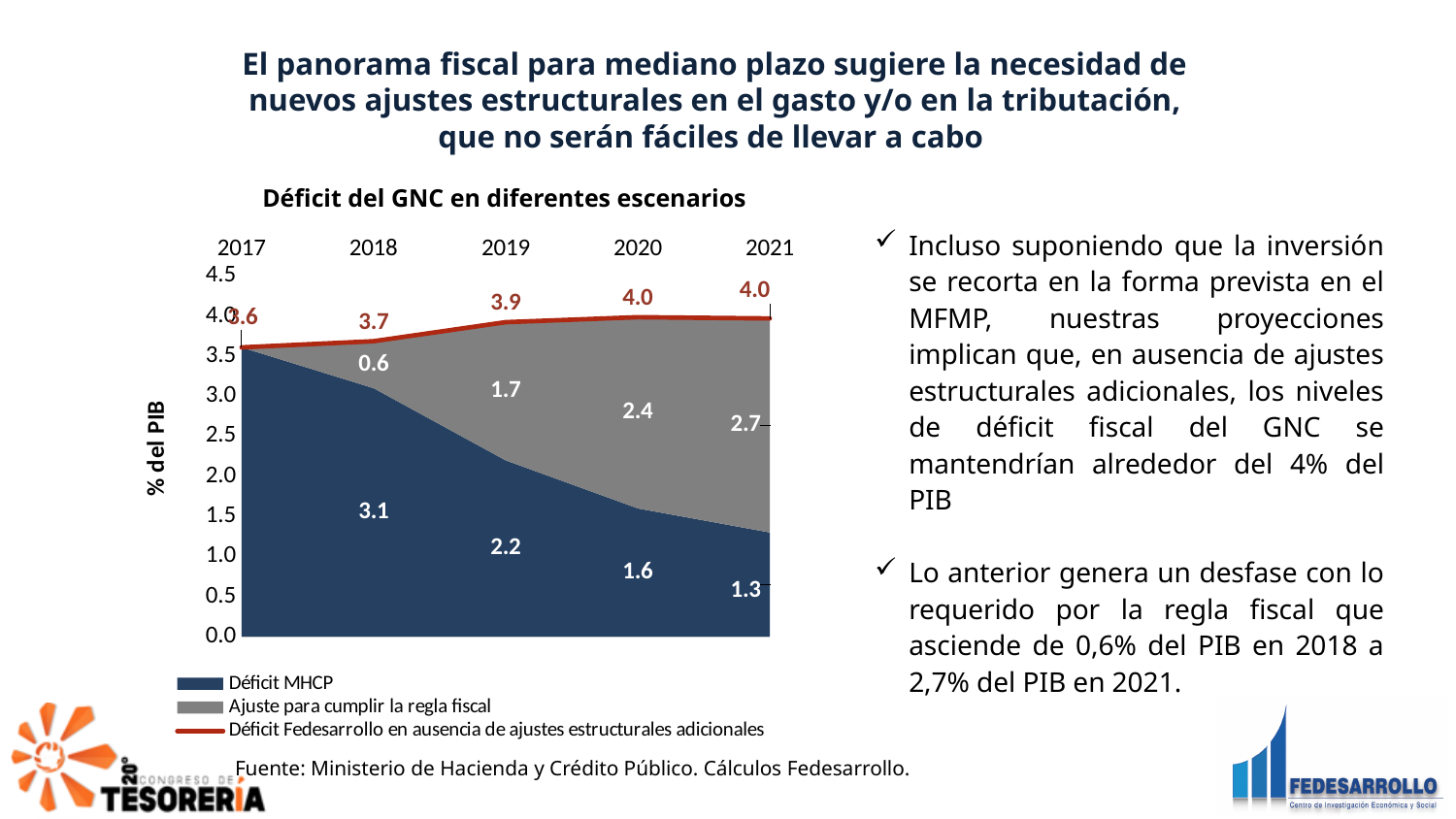
Which is larger in 2019: Déficit MHCP or Ajuste para cumplir la regla fiscal? Déficit MHCP What is the value of Déficit MHCP in 2018? 3.1 What is the title of the chart? Déficit del GNC en diferentes escenarios What is the value of Ajuste para cumplir la regla fiscal in 2021? 2.7 What is the difference between Ajuste para cumplir la regla fiscal in 2021 and in 2018? 2.1 How does Déficit MHCP change from 2017 to 2021? It falls What is the value of Déficit MHCP in 2020? 1.6 What is the value of Déficit Fedesarrollo en ausencia de ajustes estructurales adicionales in 2019? 3.9 How many years are shown on the x axis? 5 How many series does the legend list? 3 In which year is Ajuste para cumplir la regla fiscal highest? 2021 In which year is Déficit MHCP lowest? 2021